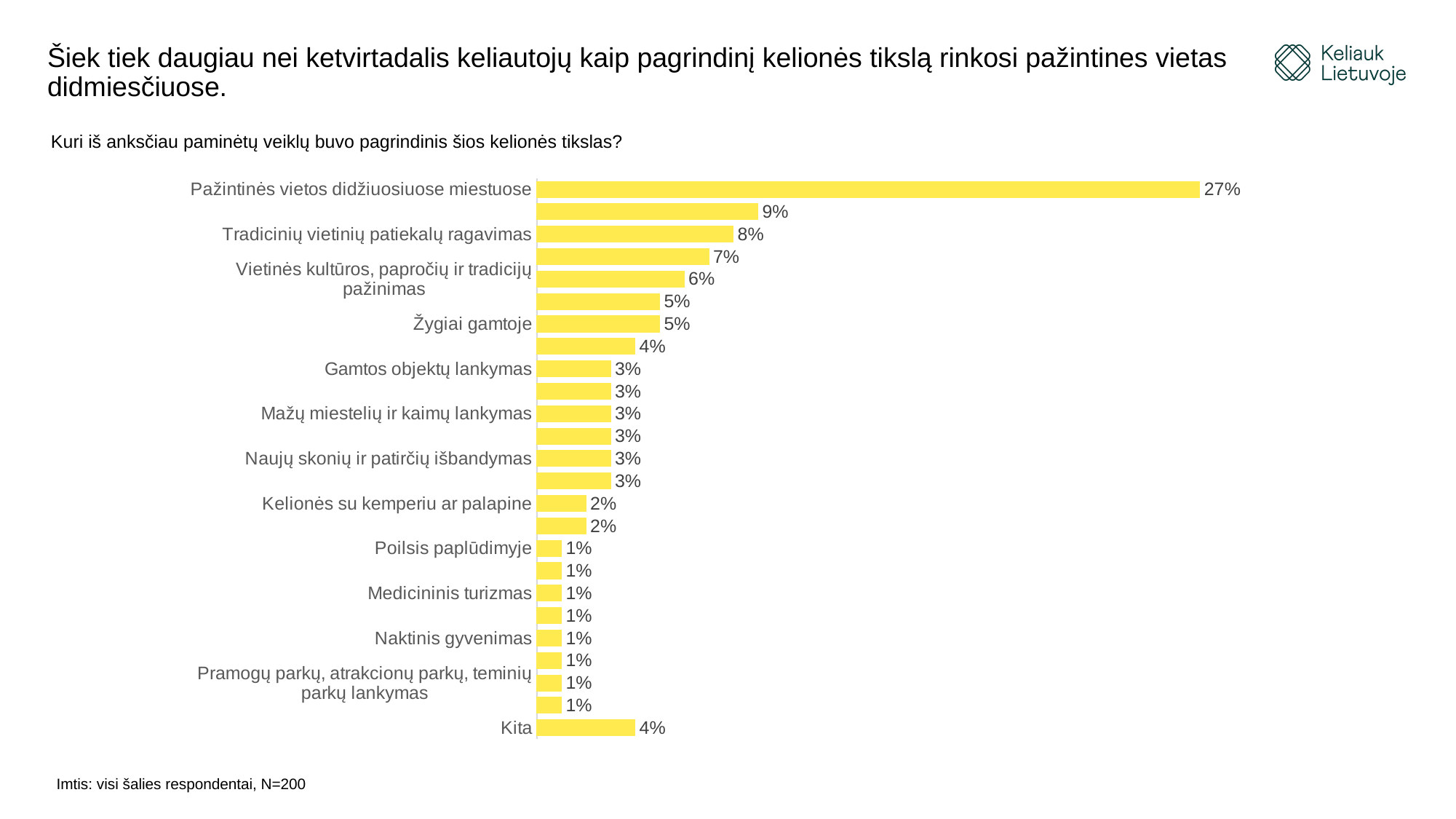
What is the value shown for "Žygiai gamtoje"? 5% What is the difference in percentage points between "Pažintinės vietos didžiuosiuose miestuose" and "Tradicinių vietinių patiekalų ragavimas"? 19 percentage points Which has a larger value: "Tradicinių vietinių patiekalų ragavimas" or "Žygiai gamtoje"? Tradicinių vietinių patiekalų ragavimas What type of chart is shown on the slide? Bar chart What survey question is the chart based on, as written above the chart? Kuri iš anksčiau paminėtų veiklų buvo pagrindinis šios kelionės tikslas? Which category has the highest value in the chart? Pažintinės vietos didžiuosiuose miestuose What is the value shown for "Tradicinių vietinių patiekalų ragavimas"? 8% How many bars are plotted in the chart? 25 Which has a larger value: "Kita" or "Poilsis paplūdimyje"? Kita What percentage of respondents chose "Pažintinės vietos didžiuosiuose miestuose" as the main purpose of the trip? 27% What is the value shown for "Kelionės su kemperiu ar palapine"? 2% What is the value shown for "Kita"? 4%